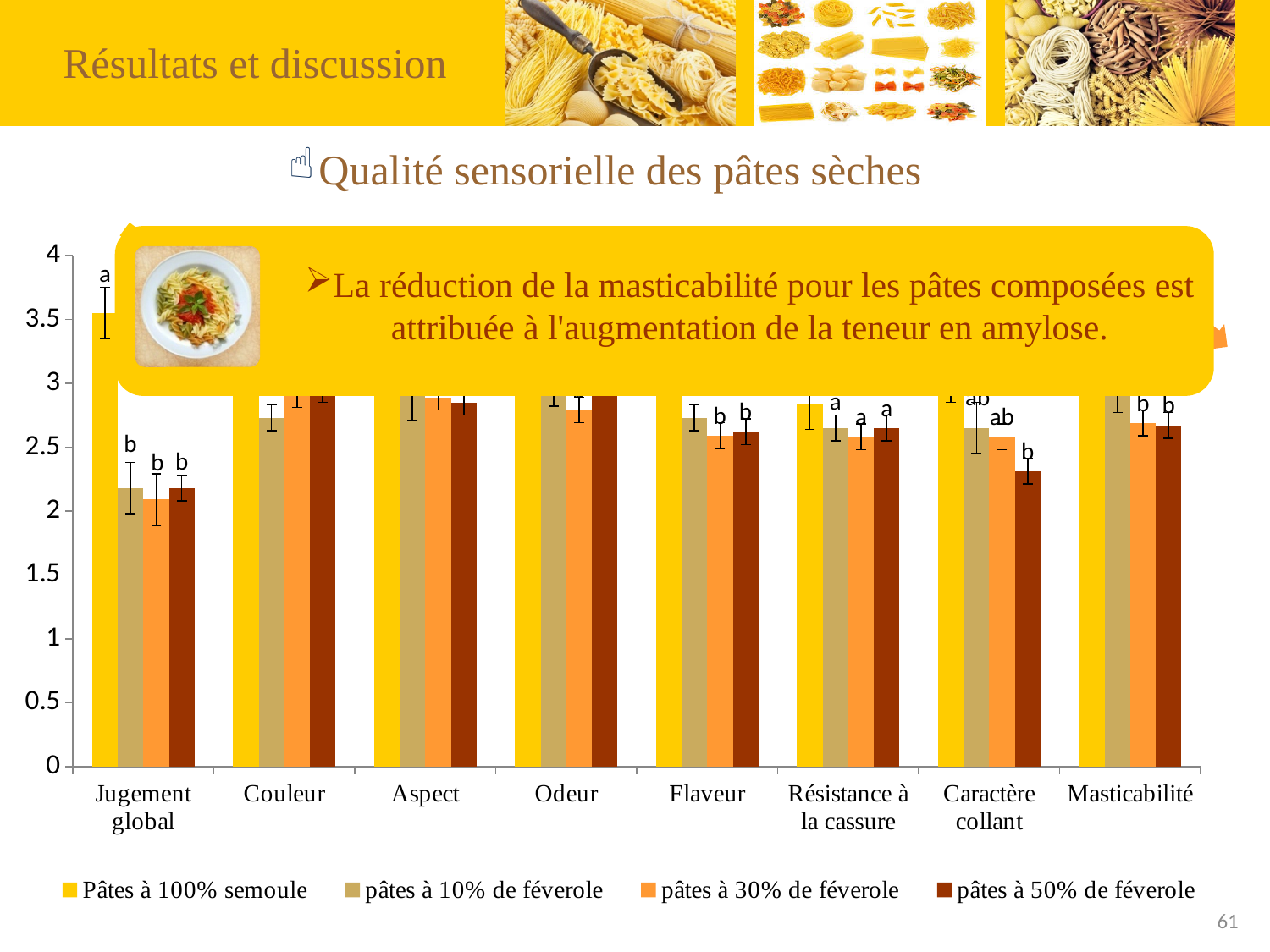
Which series has the highest value for Jugement global? Pâtes à 100% semoule Is the value for pâtes à 50% de féverole in Caractère collant greater or less than 2.5? less How many categories are shown along the x axis of the chart? 8 Is the value for pâtes à 10% de féverole in Masticabilité greater or less than 2.5? greater What kind of chart is shown on the slide? bar chart For Jugement global, which is larger: Pâtes à 100% semoule or pâtes à 10% de féverole? Pâtes à 100% semoule Is the value for Pâtes à 100% semoule in Jugement global greater or less than 3? greater What is the title of the chart on the slide? Qualité sensorielle des pâtes sèches How many series does the chart legend list? 4 Which series is listed first in the chart legend? Pâtes à 100% semoule For Caractère collant, which is larger: pâtes à 10% de féverole or pâtes à 50% de féverole? pâtes à 10% de féverole